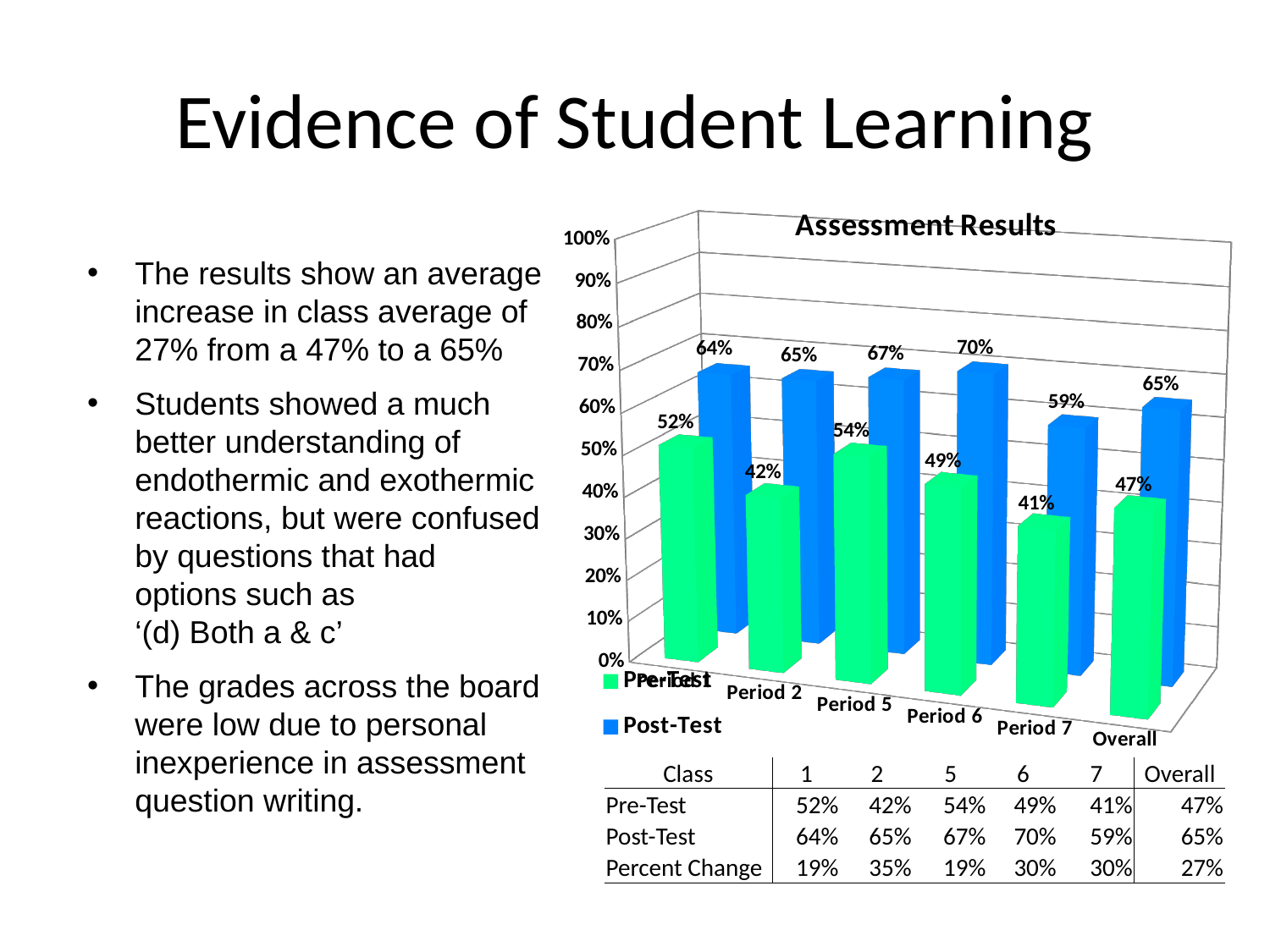
In the Assessment Results chart, is the Pre-Test value for Period 5 larger or smaller than the Pre-Test value for Period 6? larger What is the title of the chart on the slide? Assessment Results What is the Post-Test value for Period 6 in the Assessment Results chart? 70% What is the Pre-Test value for Period 2 in the Assessment Results chart? 42% How many categories are shown along the x axis of the Assessment Results chart? 6 Which category has the lowest Pre-Test value in the Assessment Results chart? Period 7 What kind of chart is the Assessment Results chart? bar chart Which category has the highest Post-Test value in the Assessment Results chart? Period 6 How many series does the legend of the Assessment Results chart list? 2 Which colour represents the Post-Test series in the Assessment Results chart? blue What is the difference between the Post-Test and Pre-Test values for Period 7 in the Assessment Results chart? 18% What is the Post-Test value for Overall in the Assessment Results chart? 65%